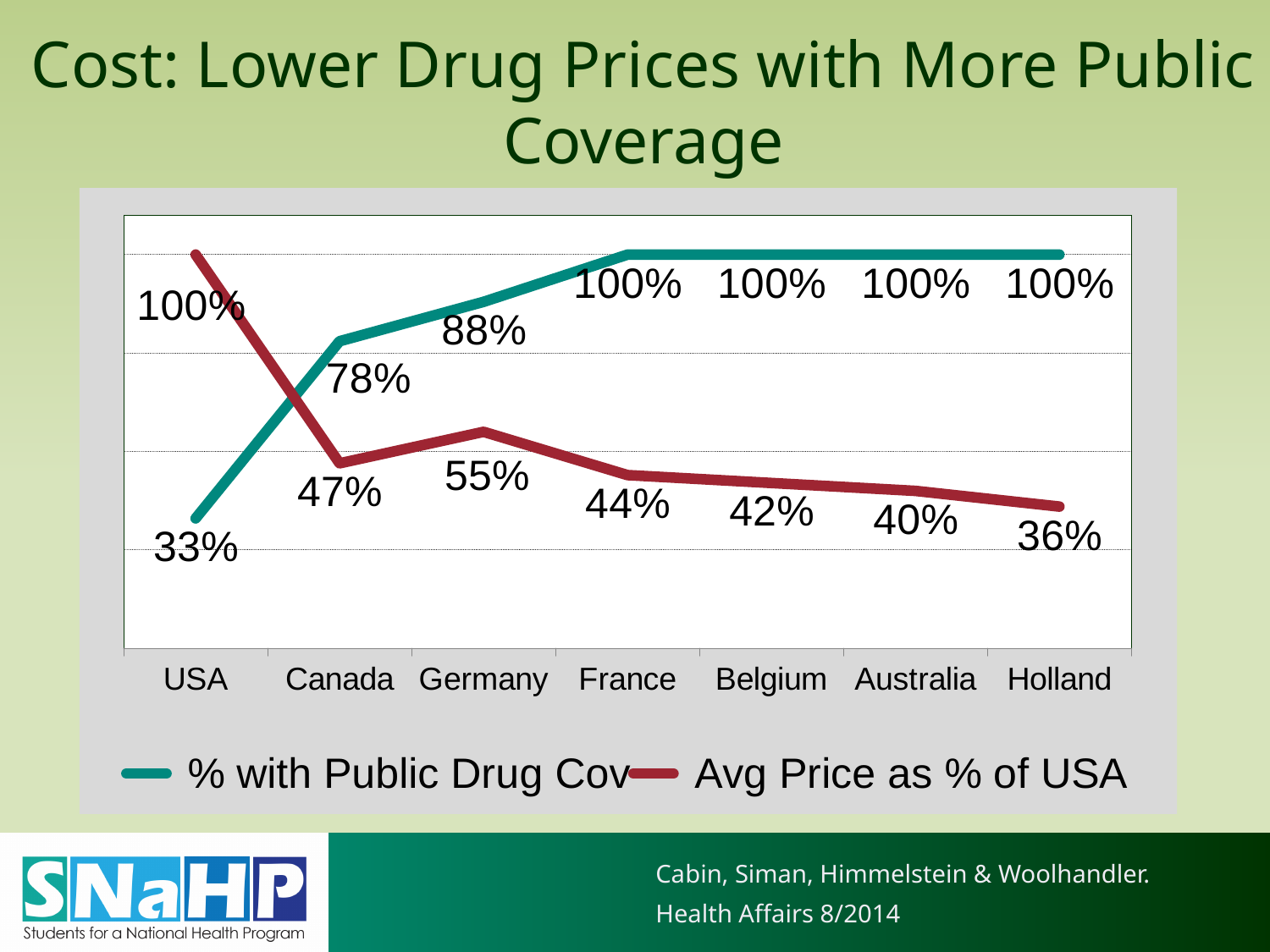
What is the Avg Price as % of USA for Germany? 55% Which is larger: the Avg Price as % of USA for Canada or for Germany? Germany What is the % with Public Drug Cov for Canada? 78% How many countries are plotted along the x axis? 7 Does the Avg Price as % of USA series generally rise or fall from USA to Holland along the x axis? fall Which country has the lowest % with Public Drug Cov? USA What is the difference between the % with Public Drug Cov for Germany and for Canada? 10% What is the Avg Price as % of USA for Holland? 36% How many series does the legend list? 2 Which country has the lowest Avg Price as % of USA? Holland Which country has the highest Avg Price as % of USA? USA What kind of chart is shown on the slide? line chart